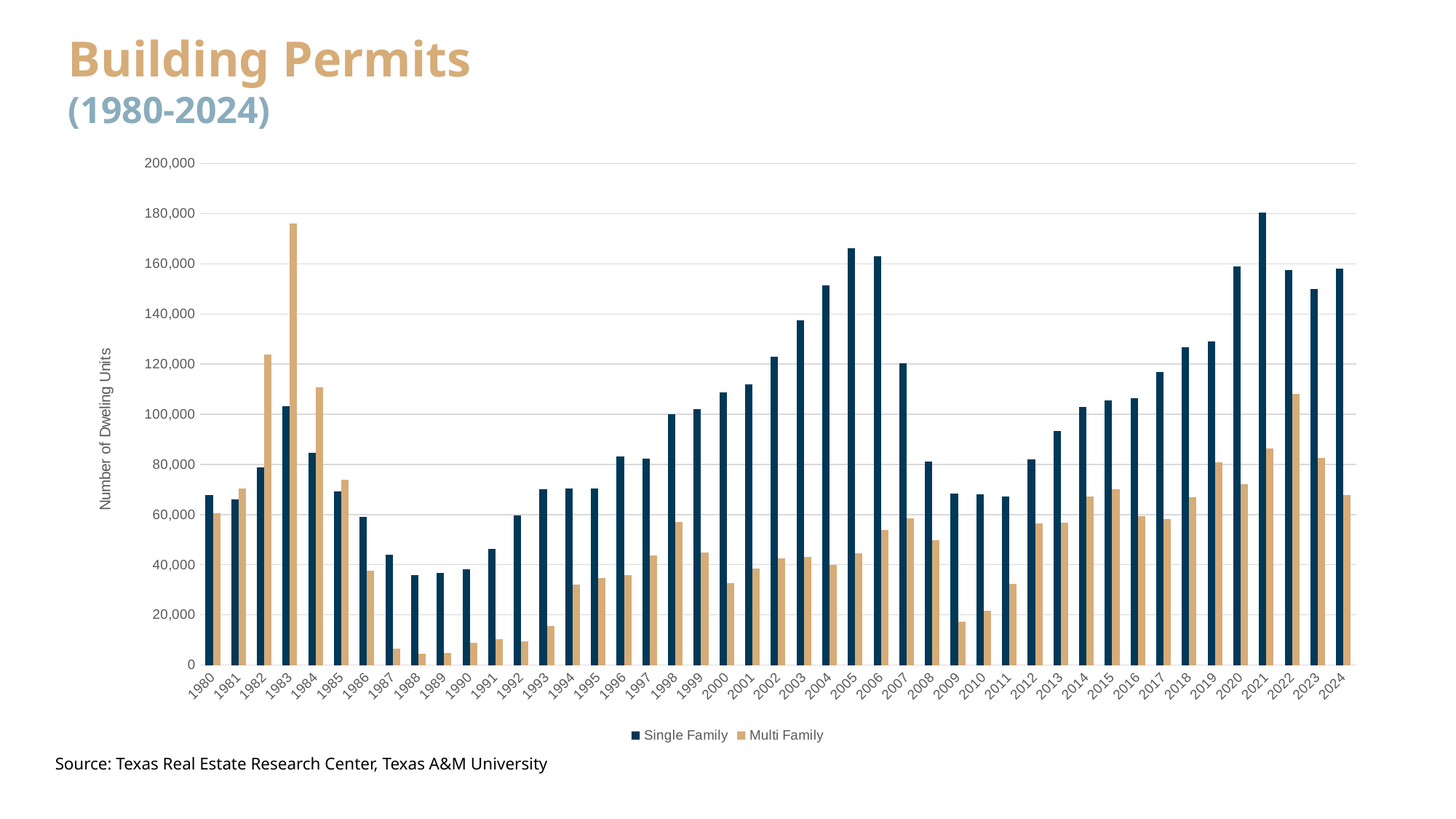
What kind of chart is shown on the slide? bar chart Is the Single Family value for 2021 greater or less than 160,000? greater How many years are shown along the x axis? 45 In which year is the Single Family value highest? 2021 Is the Multi Family value for 1983 greater or less than 160,000? greater How many series does the legend list? 2 In 1983, which series has the larger value, Single Family or Multi Family? Multi Family Is the Multi Family value for 2009 greater or less than 20,000? less Which is larger, the Single Family value for 2010 or for 2019? 2019 Do the Single Family values rise or fall from 2011 to 2021? rise In which year is the Multi Family value highest? 1983